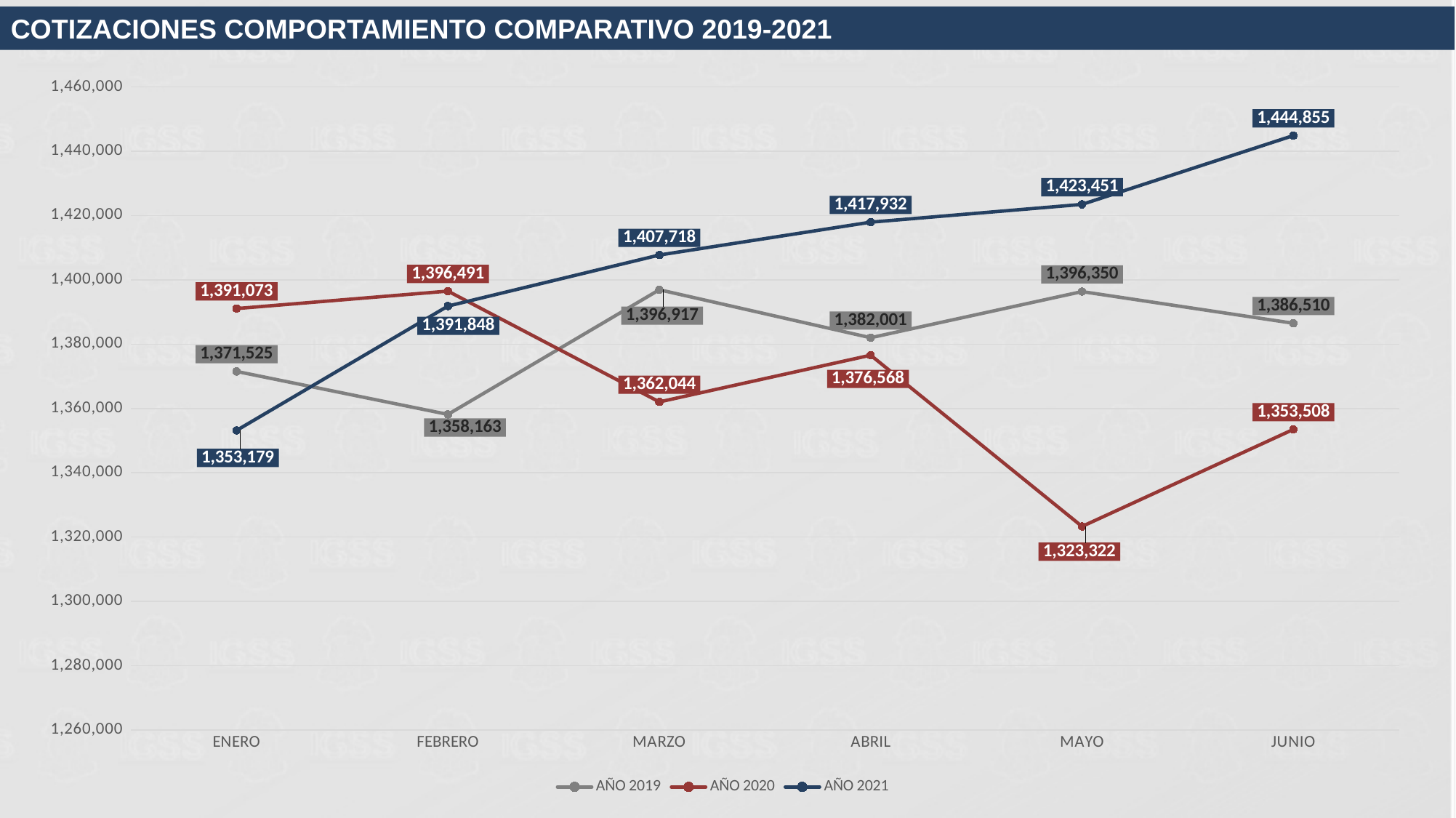
What is the difference between the AÑO 2019 values in MARZO and FEBRERO? 38,754 In ENERO, which series has the larger value, AÑO 2019 or AÑO 2020? AÑO 2020 What kind of chart is shown on the slide? Line chart What is the value for AÑO 2021 in JUNIO? 1,444,855 In which month does the AÑO 2021 series reach its highest value? JUNIO In which month does the AÑO 2020 series reach its lowest value? MAYO How many months are shown on the x axis? 6 What is the value for AÑO 2020 in MAYO? 1,323,322 Does the AÑO 2021 series rise or fall from ENERO to JUNIO? Rise What is the value for AÑO 2019 in FEBRERO? 1,358,163 What is the difference between the AÑO 2021 and AÑO 2020 values in JUNIO? 91,347 How many series does the legend list? 3